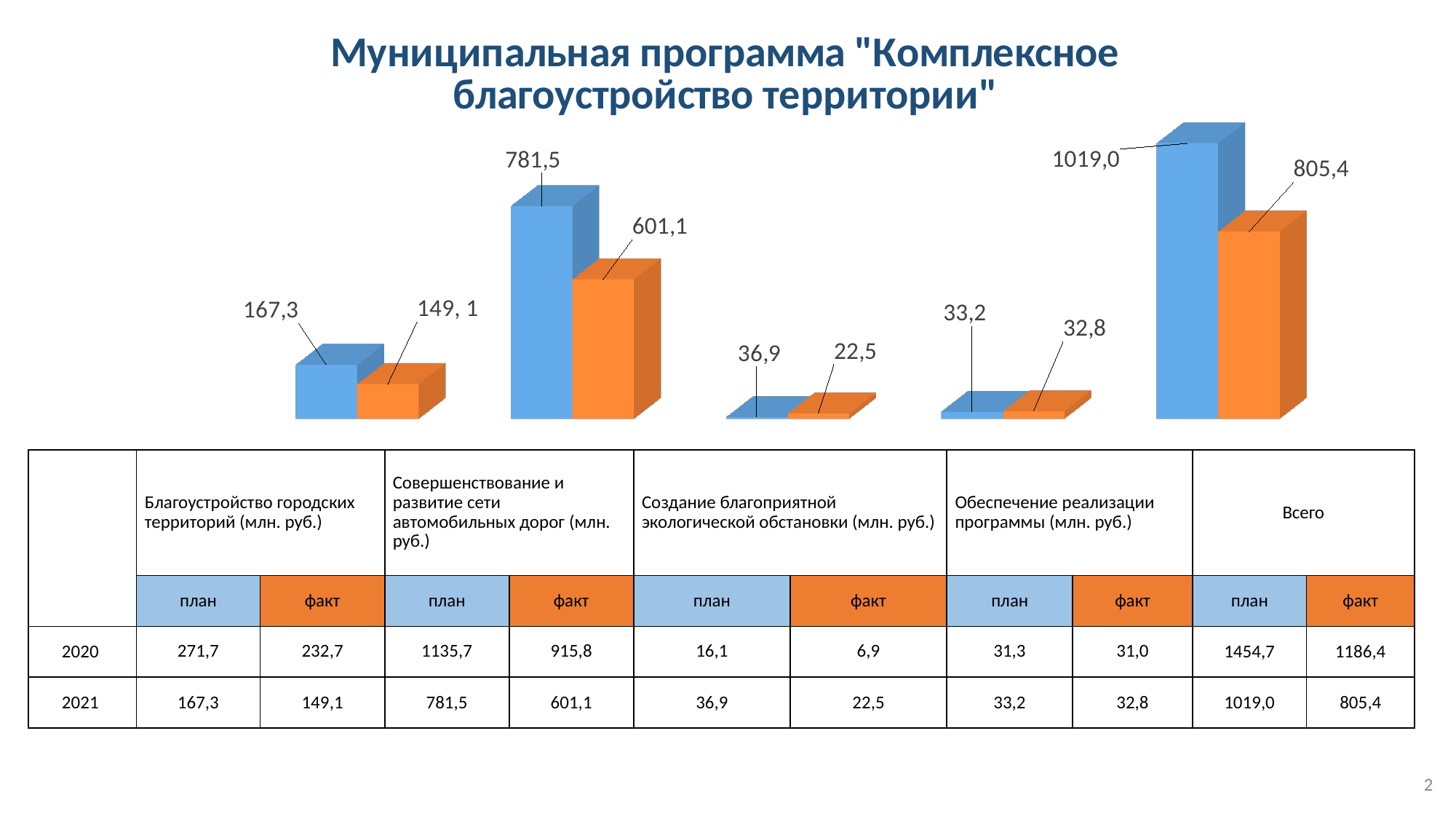
Which category has the lowest orange (факт) bar? Создание благоприятной экологической обстановки Which category has the tallest blue (план) bar? Всего What is the difference between the план and факт bars for Совершенствование и развитие сети автомобильных дорог? 180,4 How many categories (groups of bars) does the chart show? 5 What kind of chart is shown on the slide? bar chart What is the value of the blue (план) bar for Совершенствование и развитие сети автомобильных дорог? 781,5 What is the difference between the план and факт bars for Всего? 213,6 What is the value of the orange (факт) bar for Всего? 805,4 Which colour represents факт in the chart? orange What is the value of the blue (план) bar for Создание благоприятной экологической обстановки? 36,9 What is the value of the orange (факт) bar for Благоустройство городских территорий? 149,1 Which is larger for Обеспечение реализации программы: the план bar or the факт bar? план